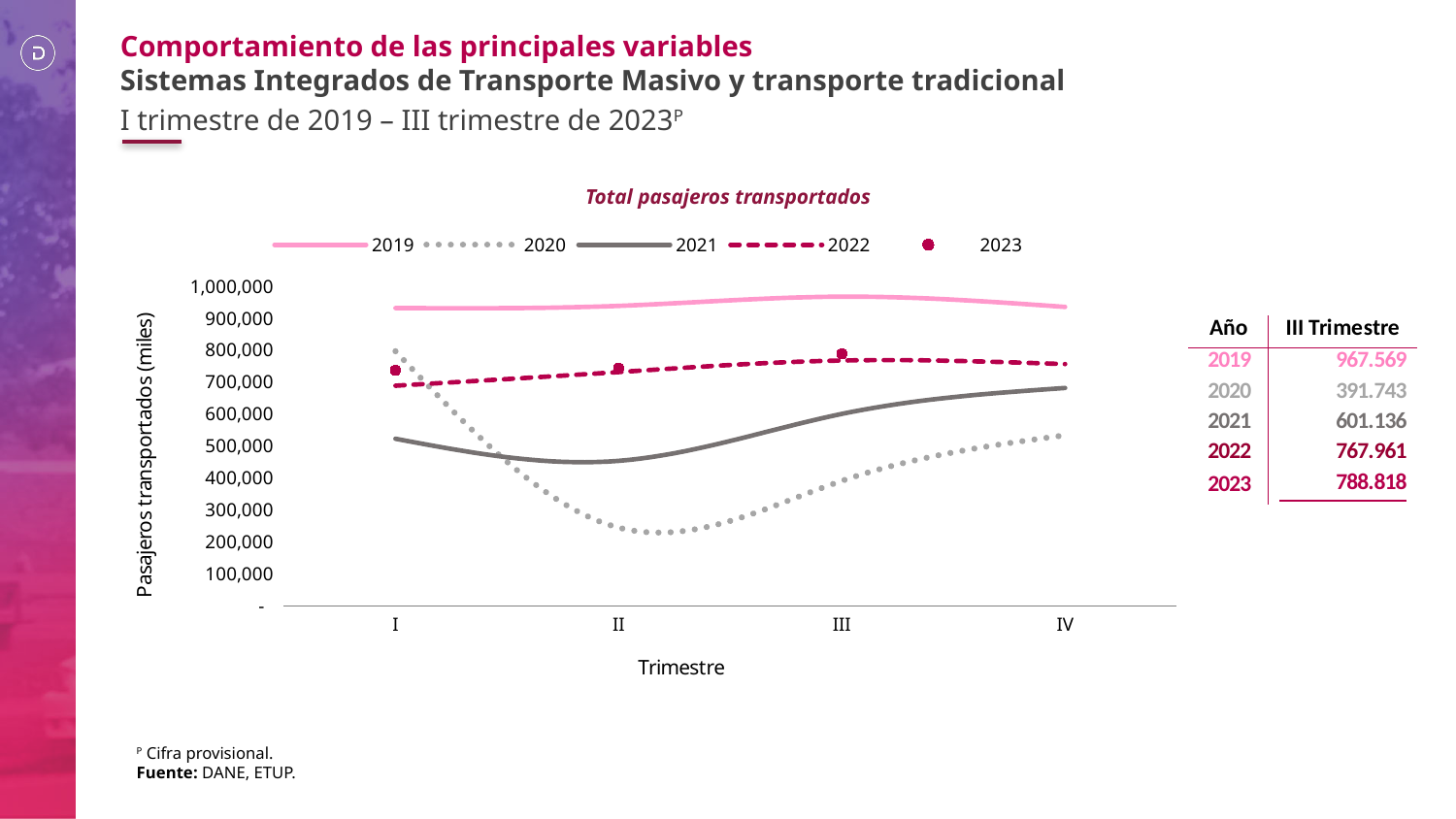
What is the title of the chart? Total pasajeros transportados Does the 2021 line rise or fall from trimestre II to trimestre IV? rise In the III Trimestre, which is larger: the value for 2022 or the value for 2023? 2023 How many series does the legend of the chart list? 5 What kind of chart is shown on the slide? line chart Which year has the highest value in the III Trimestre? 2019 How many quarters (trimestres) are shown along the x axis of the chart? 4 According to the table, what is the value for 2020 in the III Trimestre? 391.743 Which year has the lowest value in the III Trimestre? 2020 According to the table, what is the value for 2019 in the III Trimestre? 967.569 What is the difference between the III Trimestre values for 2023 and 2022? 20.857 Is the value for 2020 in trimestre II greater or less than 300,000? less